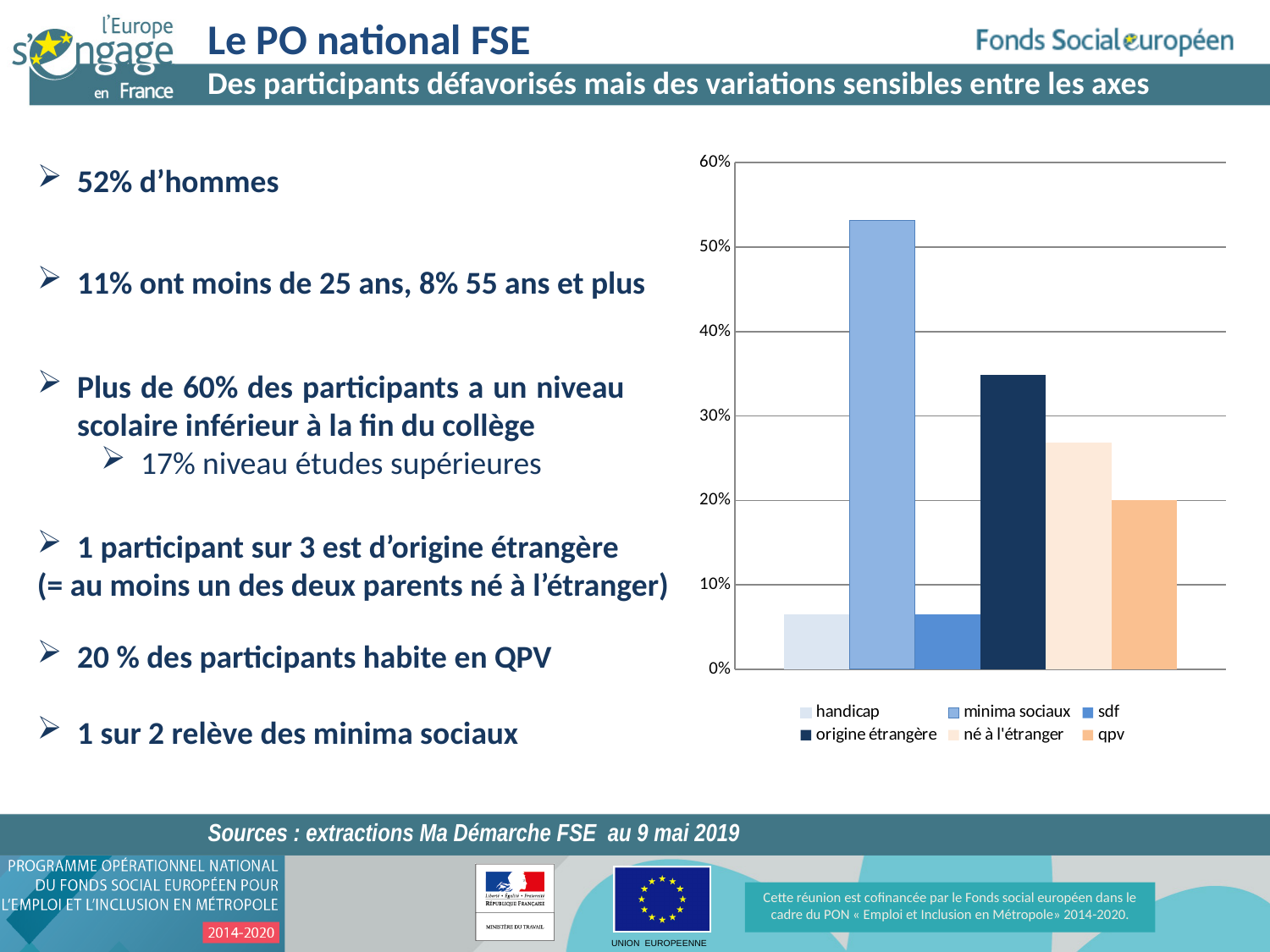
Is the value for handicap greater or less than 10%? less How many series does the chart legend list? 6 Which series has the highest bar in the chart? minima sociaux What is the value for qpv in the chart? 20% Is the value for origine étrangère greater or less than 30%? greater Is the value for sdf greater or less than 10%? less How many bars are plotted in the chart? 6 What kind of chart is shown on the slide? bar chart Which legend entry is shown in the darkest navy colour? origine étrangère Which is larger, the value for origine étrangère or the value for né à l'étranger? origine étrangère